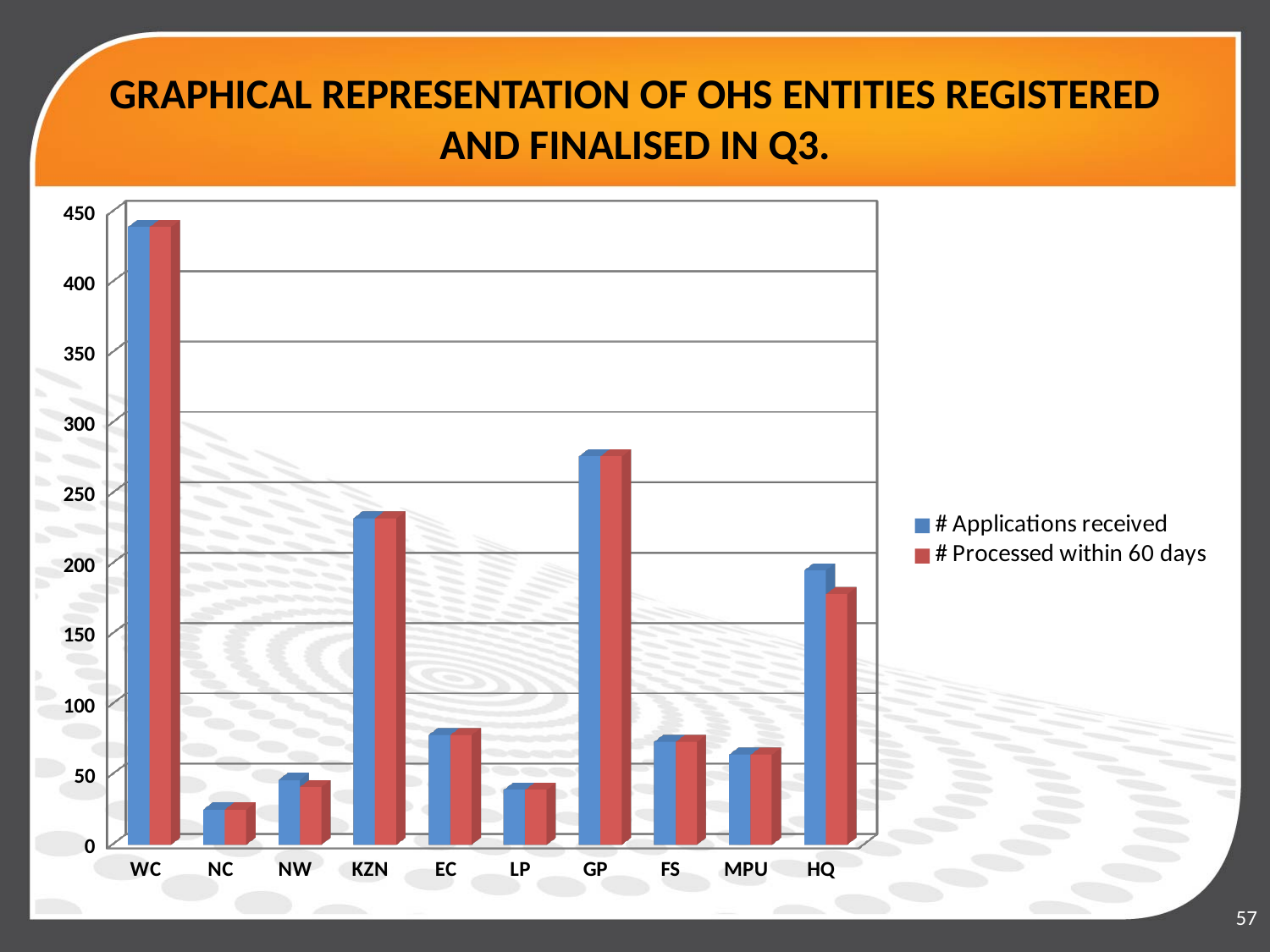
How many series does the legend list? 2 Is the number of applications received for KZN greater or less than 200? greater What kind of chart is shown on the slide? bar chart Is the number of applications received for WC greater or less than 400? greater Which category has the lowest number of applications received? NC How many categories are shown on the x axis? 10 Is the number of applications received for NC greater or less than 50? less For HQ, which is larger: applications received or processed within 60 days? # Applications received Which has more applications received, GP or KZN? GP Which category has the highest number of applications received? WC Which colour represents '# Processed within 60 days' in the legend? red